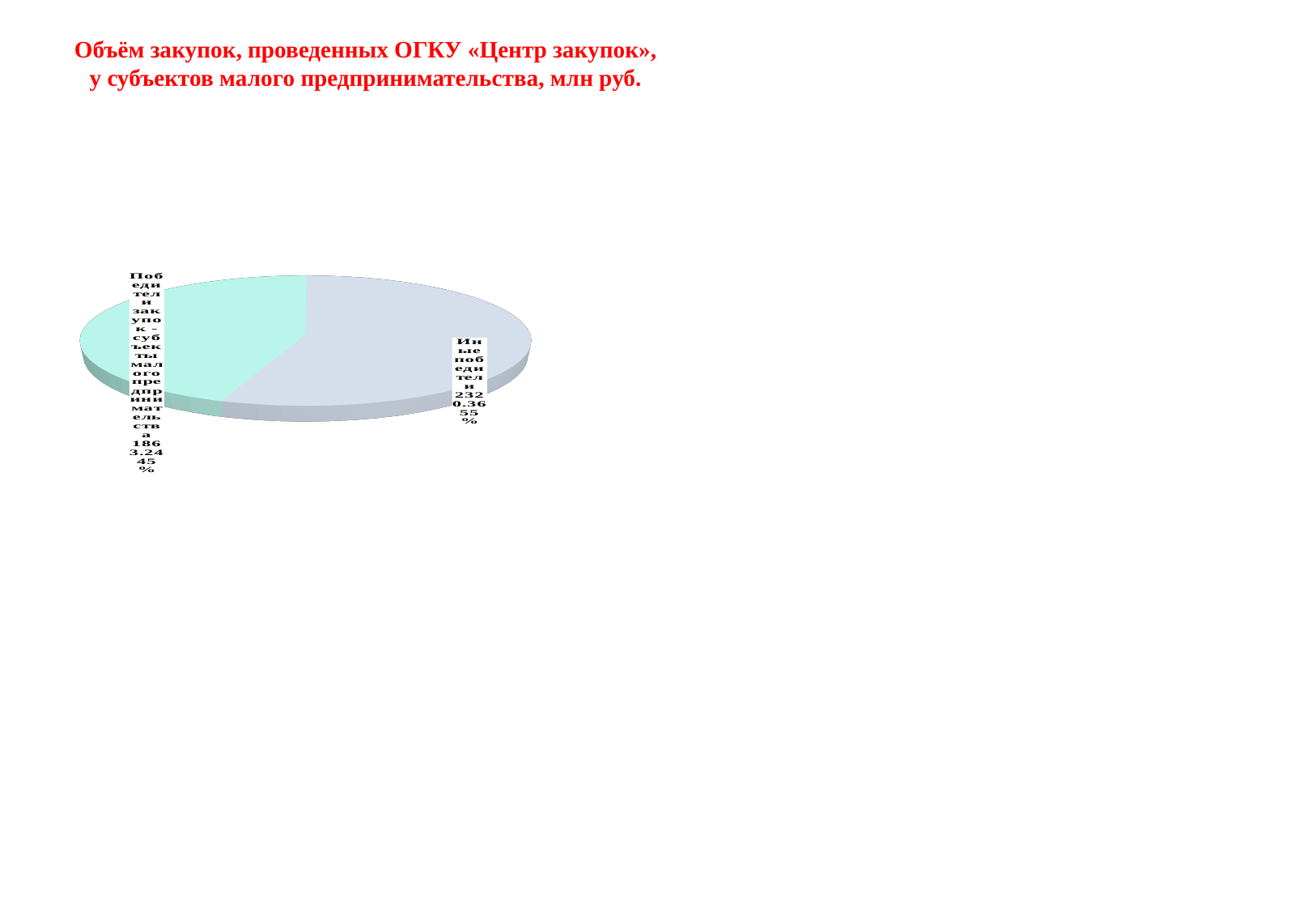
What share of the pie does the slice "Иные победители" represent? 55% Which slice of the pie chart is the largest? Иные победители What share of the pie does the slice "Победители закупок - субъекты малого предпринимательства" represent? 45% Which is larger: the value for "Иные победители" or the value for "Победители закупок - субъекты малого предпринимательства"? Иные победители How many slices does the pie chart have? 2 Which slice of the pie chart is the smallest? Победители закупок - субъекты малого предпринимательства What is the difference between the value for "Иные победители" and the value for "Победители закупок - субъекты малого предпринимательства"? 457.12 What kind of chart is shown on the slide? Pie chart What value is shown for the slice "Победители закупок - субъекты малого предпринимательства"? 1863.24 What value is shown for the slice "Иные победители"? 2320.36 What is the total of the two values shown in the pie chart? 4183.6 What unit of measurement is stated in the slide title for the purchase volumes? млн руб.